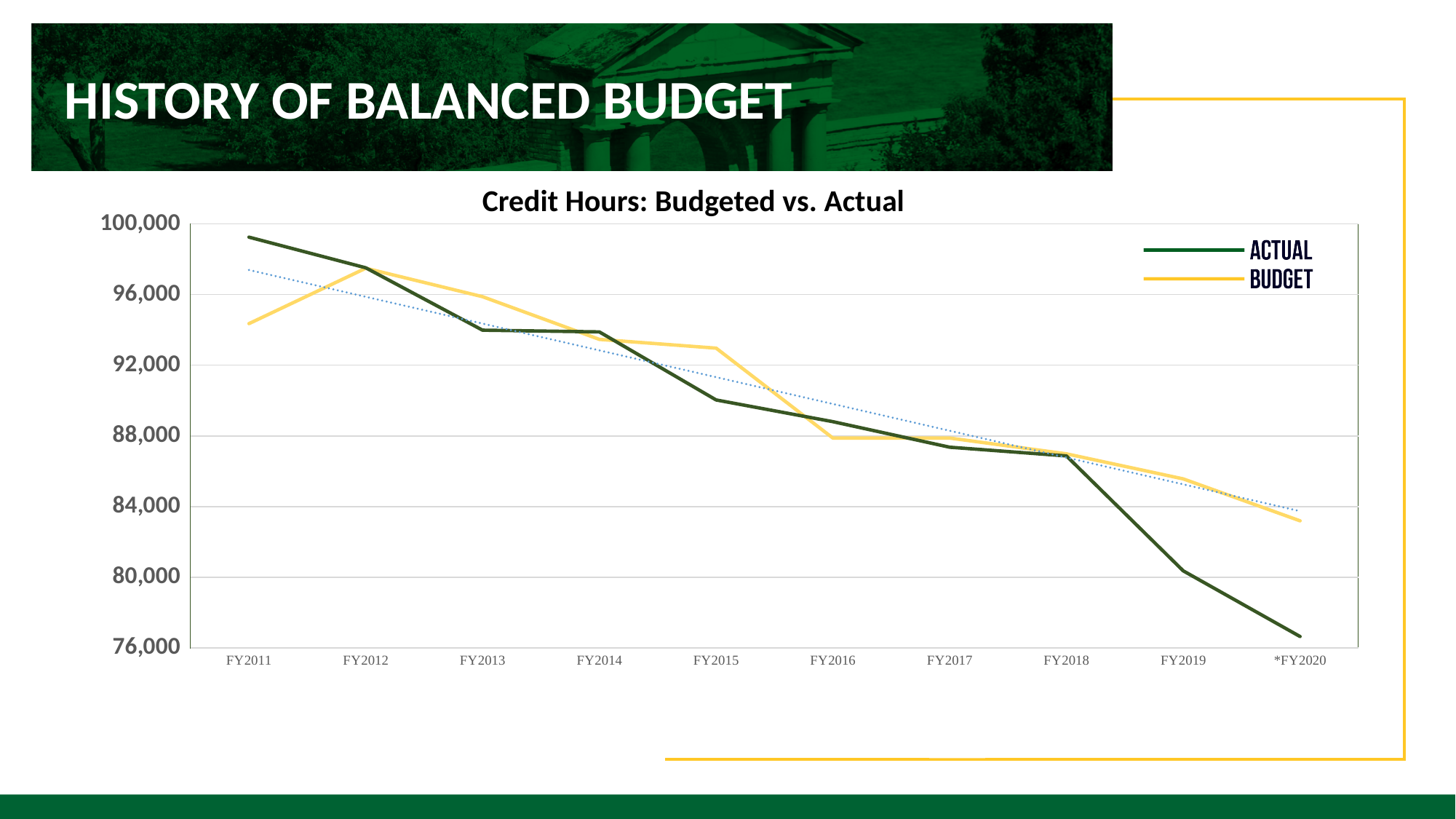
How many series does the chart legend list? 2 How many fiscal years are plotted along the x axis? 10 Do the ACTUAL credit hours generally rise or fall from FY2011 to *FY2020? Fall In which fiscal year is the ACTUAL series at its highest? FY2011 Is the ACTUAL value for *FY2020 greater or less than 80,000? less What kind of chart is shown on the slide? Line chart In FY2011, which is larger, the ACTUAL or the BUDGET value? ACTUAL In which fiscal year is the BUDGET series at its highest? FY2012 What is the title of the chart? Credit Hours: Budgeted vs. Actual Is the ACTUAL value for FY2011 greater or less than 96,000? greater In *FY2020, which is larger, the ACTUAL or the BUDGET value? BUDGET In which fiscal year is the ACTUAL series at its lowest? *FY2020